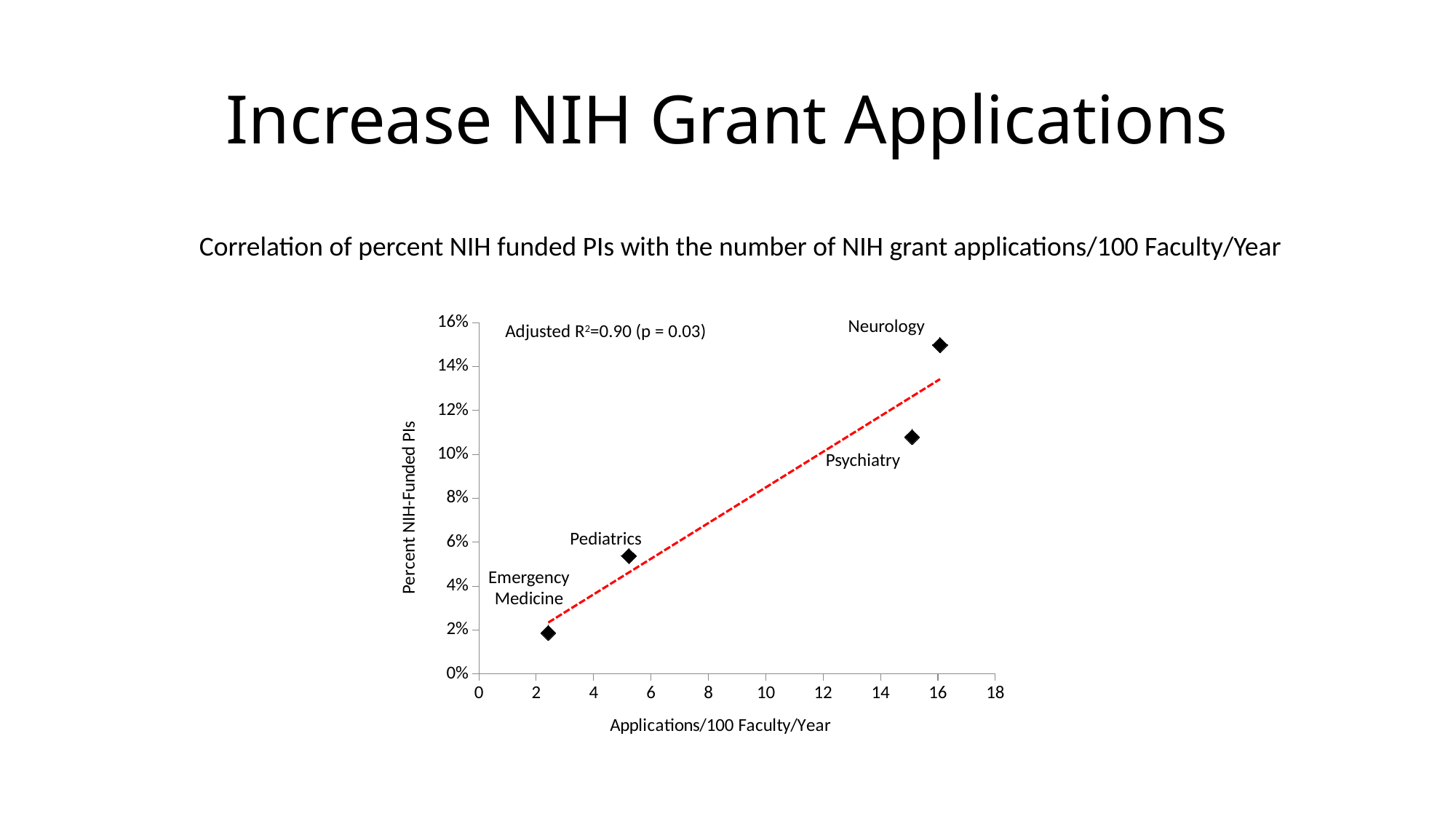
Which has a higher percent of NIH-funded PIs, Pediatrics or Psychiatry? Psychiatry Is the percent of NIH-funded PIs for Neurology greater or less than 14%? greater As applications per 100 faculty per year increase along the x axis, does the percent of NIH-funded PIs rise or fall? Rise Which department has the lowest percent of NIH-funded PIs? Emergency Medicine What kind of chart is shown on the slide? Scatter plot How many departments are plotted as points on the chart? 4 Is the percent of NIH-funded PIs for Psychiatry greater or less than 12%? less What adjusted R² value is printed on the chart? 0.90 Is the number of applications per 100 faculty per year for Emergency Medicine greater or less than 4? less Which department has the highest percent of NIH-funded PIs? Neurology Which department has the fewest applications per 100 faculty per year? Emergency Medicine